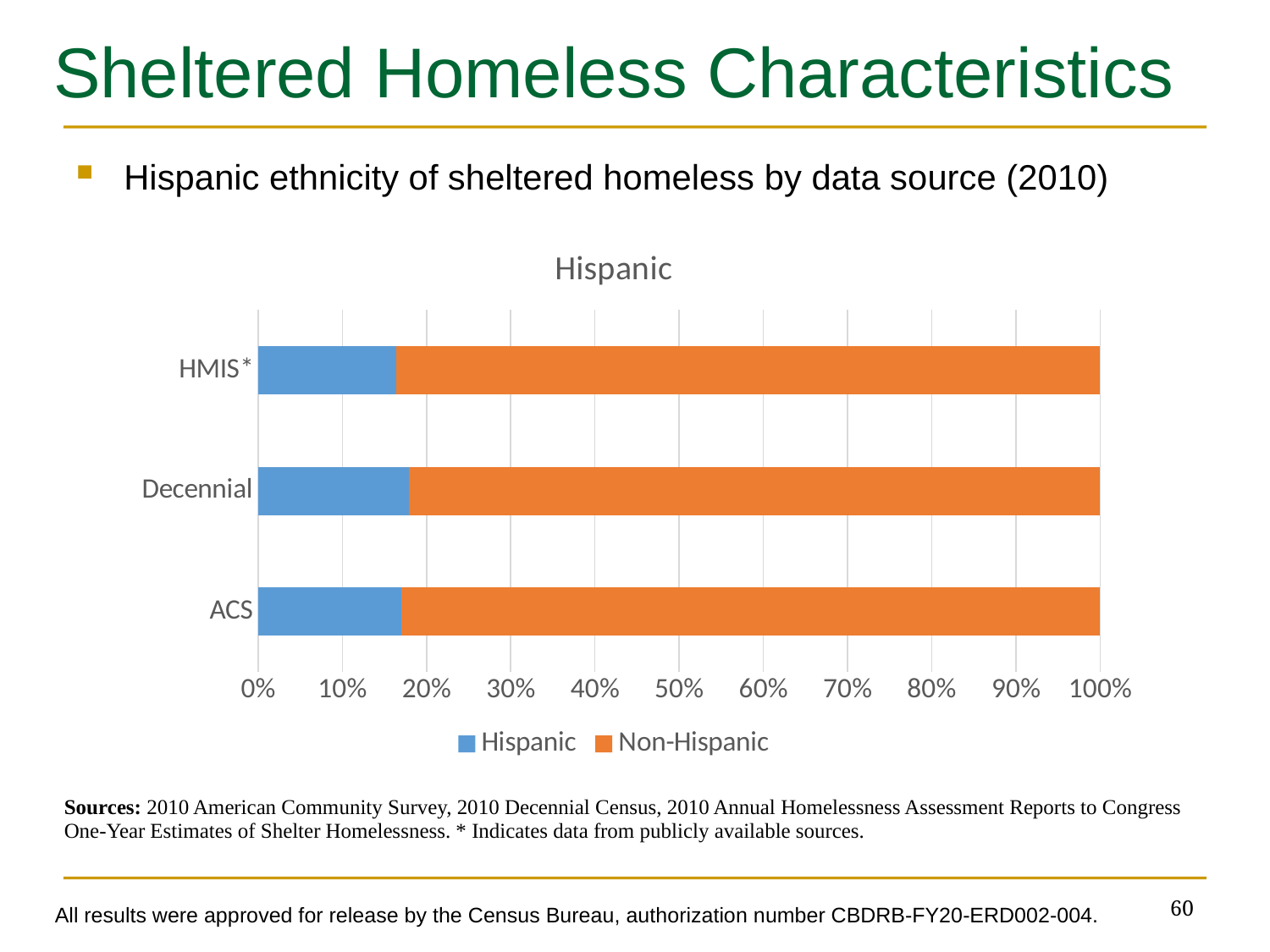
Is the Hispanic share for HMIS* greater or less than 20%? less Is the Non-Hispanic share for HMIS* greater or less than 80%? greater How many data sources (categories) are shown on the chart? 3 For the Decennial bar, which is larger, the Hispanic or the Non-Hispanic segment? Non-Hispanic How many series does the chart legend list? 2 What is the total of the stacked bar for ACS? 100% Is the Hispanic share for ACS greater or less than 20%? less What kind of chart is shown on the slide? Stacked bar chart Which series is shown in blue in the chart? Hispanic What is the title of the chart? Hispanic